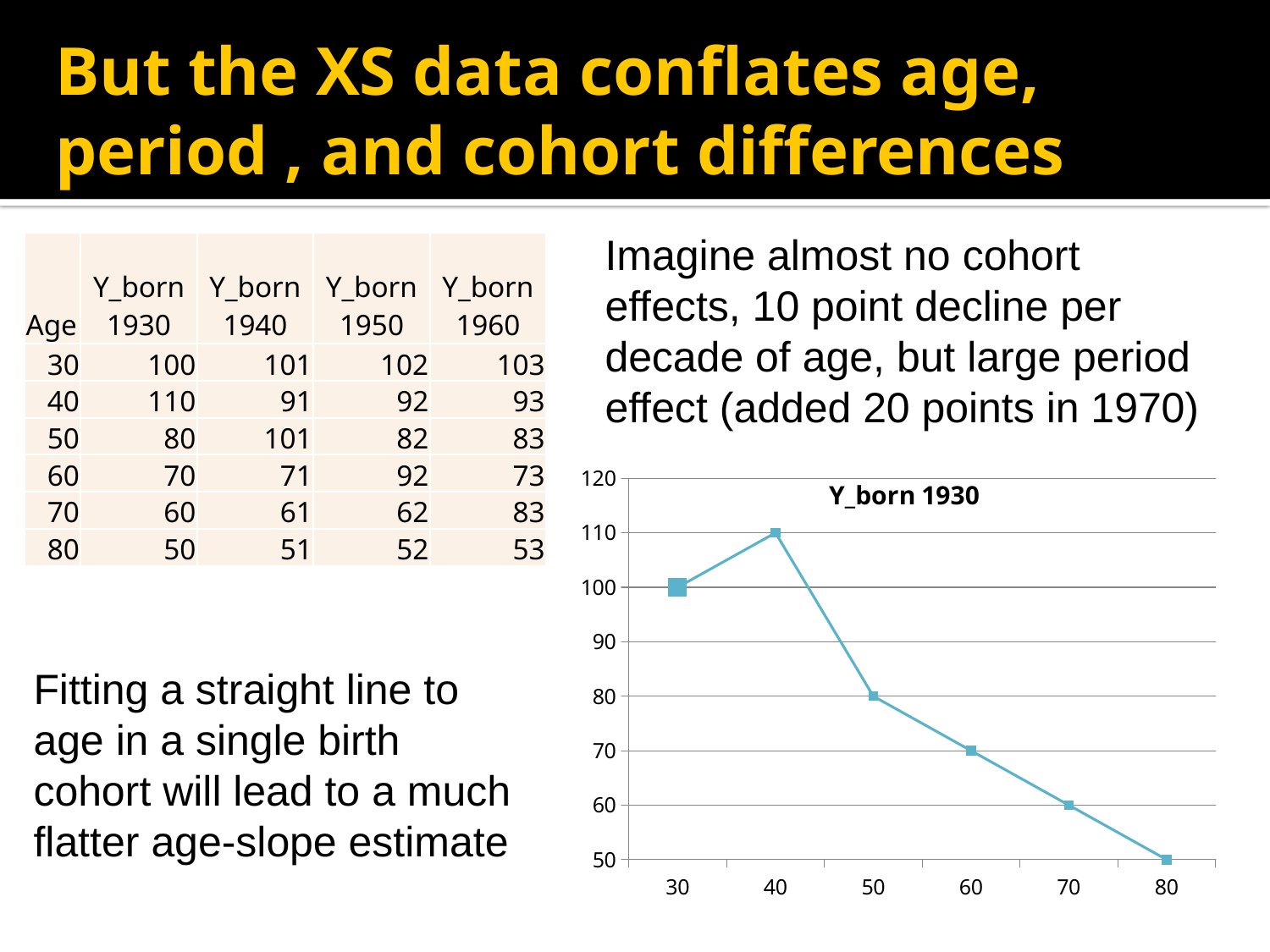
What is the value at age 40 on the chart? 110 What is the value at age 30 on the chart? 100 From age 40 to age 80, do the values rise or fall? fall How many data points are plotted on the line? 6 Which is larger, the value at age 30 or the value at age 50? age 30 What is the title of the chart? Y_born 1930 At which age is the plotted value highest? 40 What is the difference between the values at age 40 and age 50? 30 What is the value at age 80 on the chart? 50 What kind of chart is shown on the slide? line chart At which age is the plotted value lowest? 80 Is the value at age 60 greater or less than 80? less